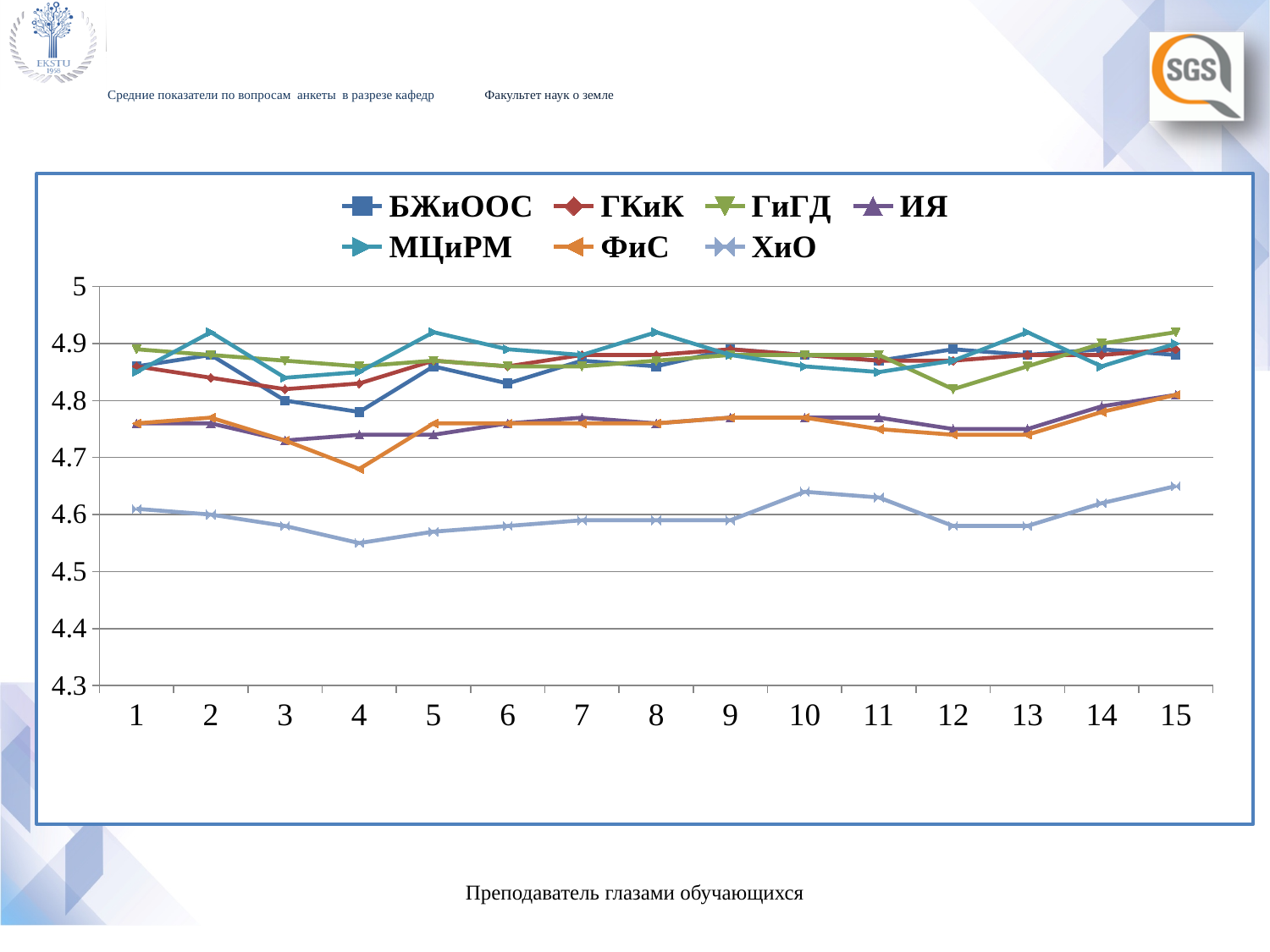
Which series is shown with the orange line in the legend? ФиС What kind of chart is shown on the slide? line chart Does the value for ХиО rise or fall from point 12 to point 15? rise Which series has the lowest value at point 1? ХиО Is the value for ИЯ at point 1 greater or less than 4.8? less At point 4, which is larger: the value for ФиС or the value for ХиО? ФиС Is the value for ХиО at point 4 greater or less than 4.6? less Is the value for ХиО at point 10 greater or less than 4.6? greater Which series has the lowest value at point 10? ХиО How many series does the legend list? 7 How many points are there along the x axis? 15